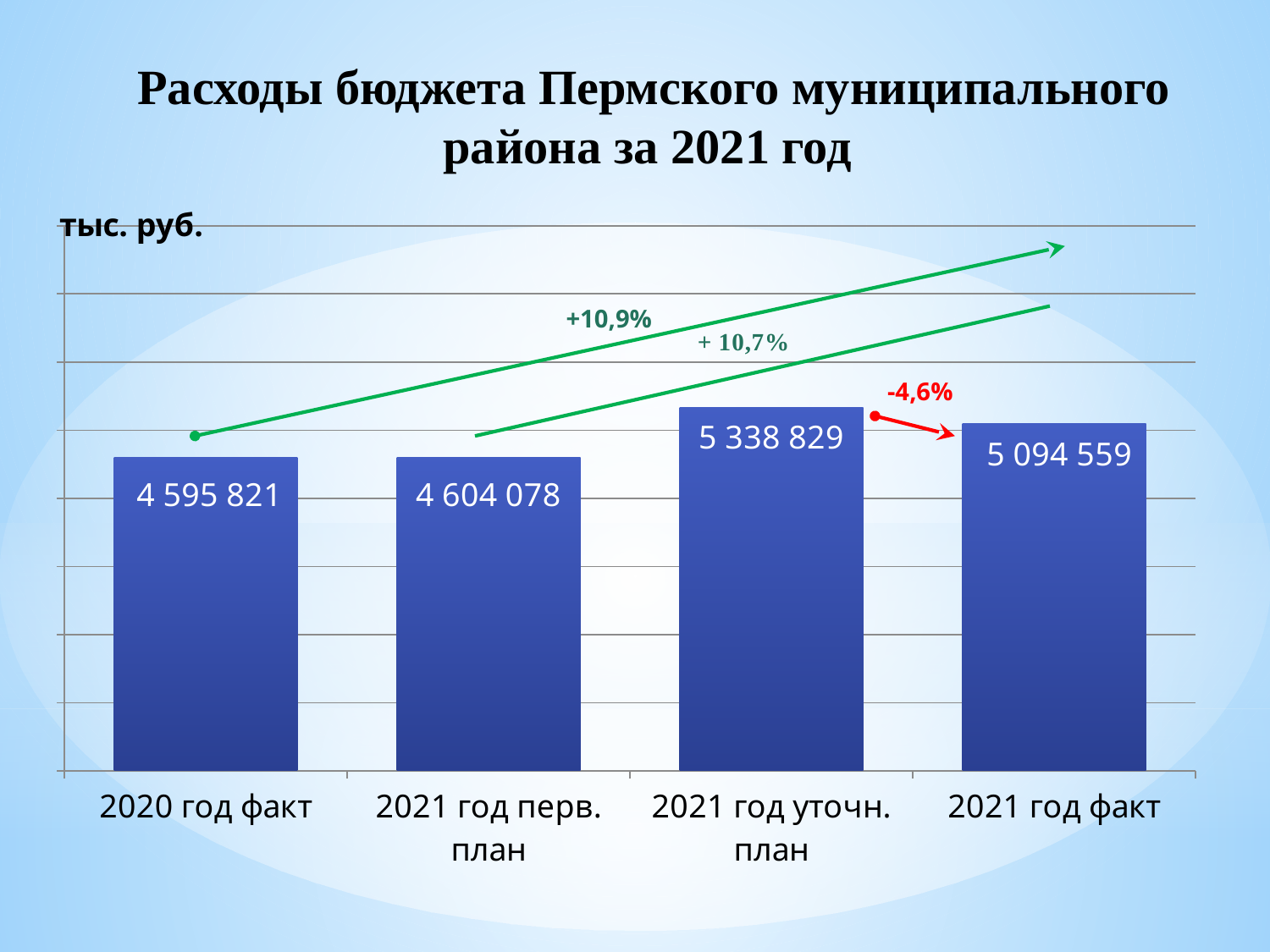
What is the value for 2020 год факт? 4 595 821 What kind of chart is shown on the slide? Bar chart What is the value for 2021 год факт? 5 094 559 Which is larger, the value for 2021 год уточн. план or the value for 2021 год факт? 2021 год уточн. план Which category has the lowest value? 2020 год факт What percentage change is shown by the red arrow between 2021 год уточн. план and 2021 год факт? -4,6% What is the difference between the values for 2021 год уточн. план and 2021 год факт? 244 270 What is the value for 2021 год уточн. план? 5 338 829 What is the difference between the values for 2021 год факт and 2020 год факт? 498 738 What is the value for 2021 год перв. план? 4 604 078 Which category has the highest value? 2021 год уточн. план How many bars are shown in the chart? 4